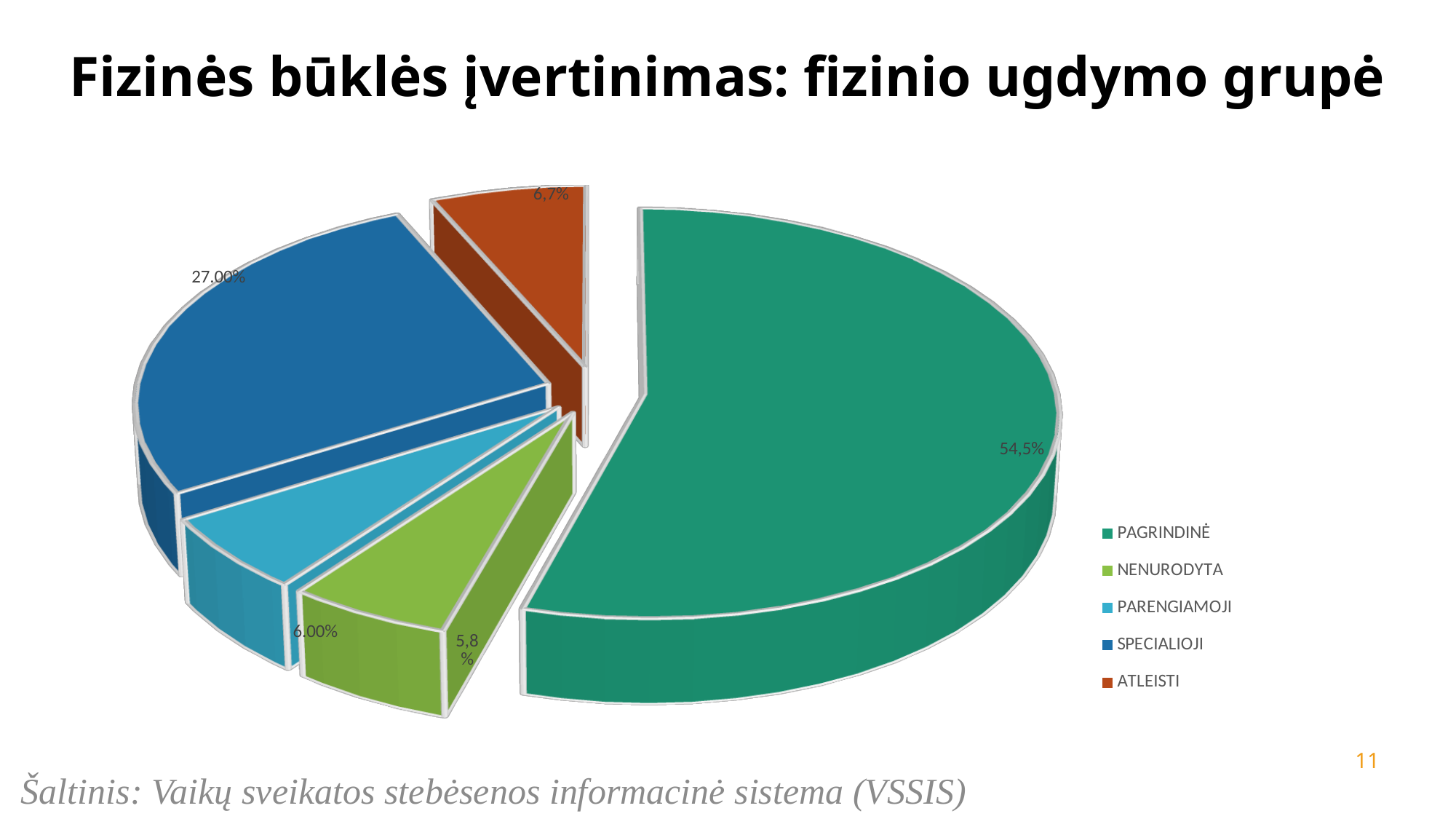
What is the difference between the shares for ATLEISTI and NENURODYTA? 0,9% Which is larger, the share for ATLEISTI or the share for NENURODYTA? ATLEISTI What share of the pie does NENURODYTA have? 5,8% What share of the pie does PARENGIAMOJI have? 6.00% What share of the pie does PAGRINDINĖ have? 54,5% Which category has the smallest slice of the pie? NENURODYTA What is the title of the chart slide? Fizinės būklės įvertinimas: fizinio ugdymo grupė What share of the pie does ATLEISTI have? 6,7% What share of the pie does SPECIALIOJI have? 27.00% Which category has the largest slice of the pie? PAGRINDINĖ What type of chart is shown on the slide? pie chart How many categories does the pie chart show? 5